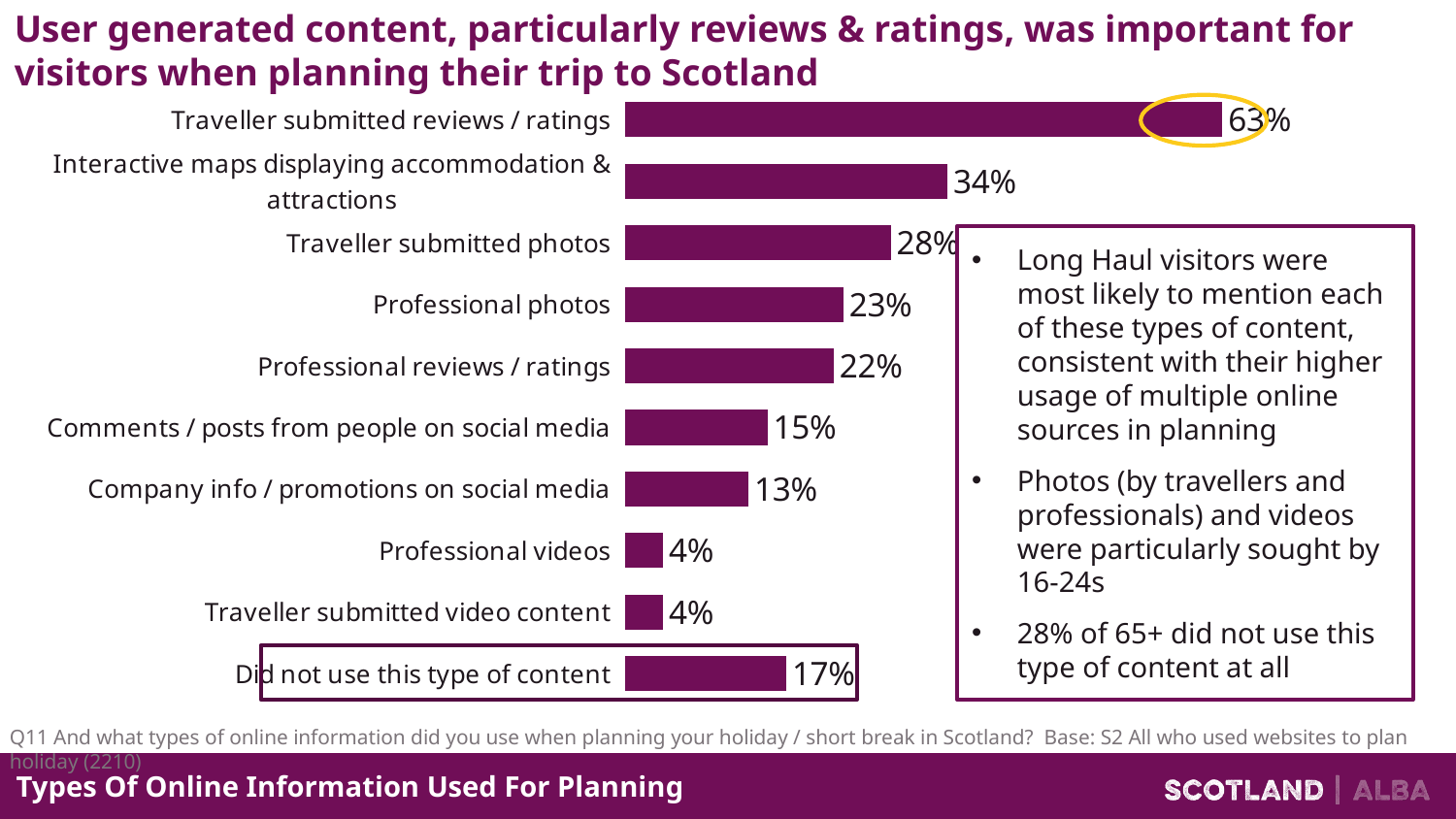
What is the value for interactive maps displaying accommodation & attractions? 34% What is the difference between traveller submitted photos and professional photos? 5% What percentage did not use this type of content? 17% Which data label on the chart is circled in yellow? 63% What kind of chart is shown on the slide? Bar chart What is the value for professional reviews / ratings? 22% What value is shown for professional videos? 4% What percentage of visitors used traveller submitted reviews / ratings when planning? 63% What is the difference between traveller submitted reviews / ratings and interactive maps displaying accommodation & attractions? 29% How many categories are shown in the bar chart? 10 Which is larger: comments / posts from people on social media or company info / promotions on social media? Comments / posts from people on social media Which type of online information has the highest value in the chart? Traveller submitted reviews / ratings